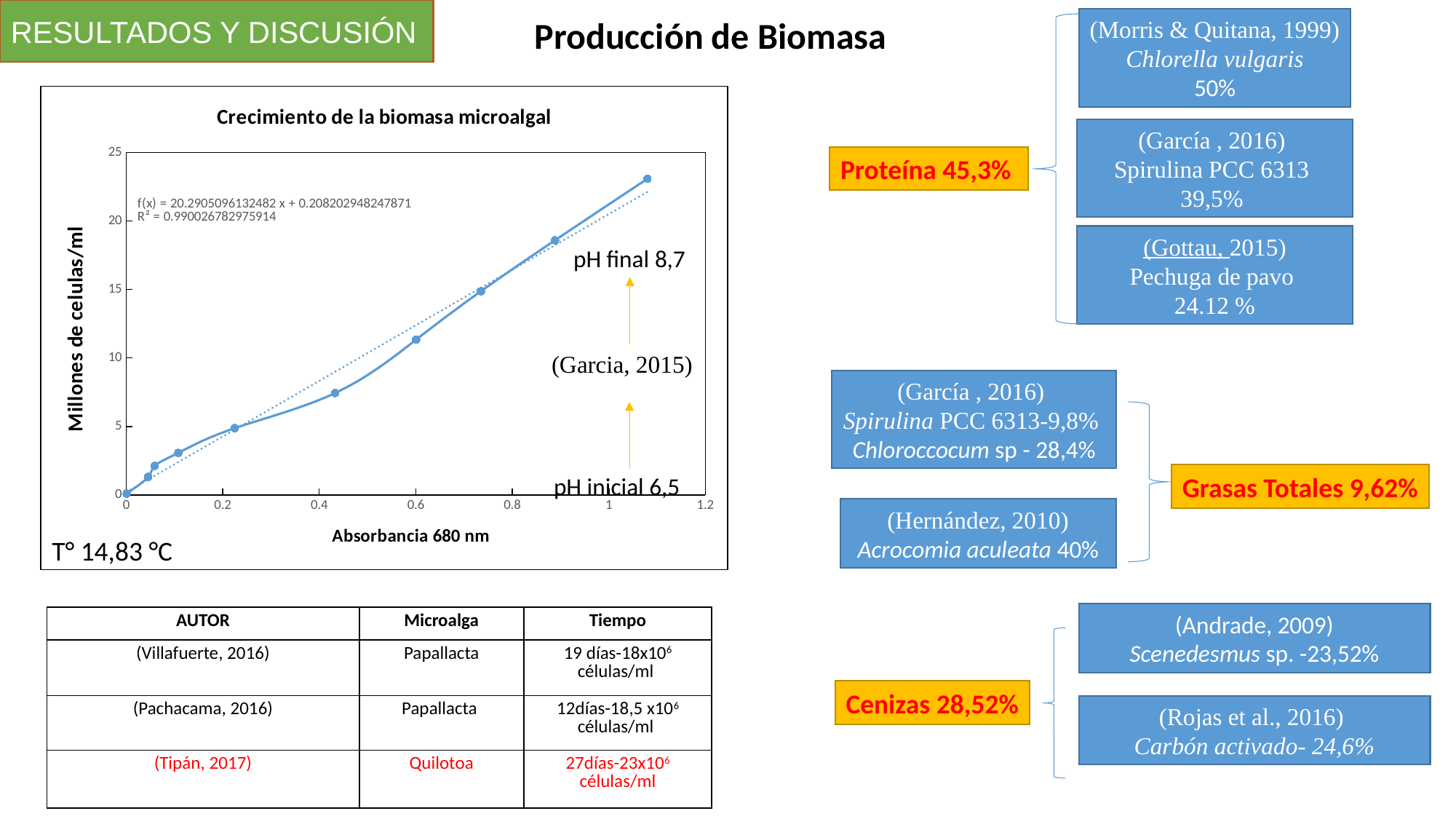
What is the label of the y axis of the chart? Millones de celulas/ml Is the value of the data point at an absorbance of about 0.9 greater or less than 20 million cells/ml? less What is the maximum value shown on the x axis of the chart? 1.2 What is the slope of the trendline equation f(x) shown in the chart? 20.2905096132482 Is the value of the data point at an absorbance of about 0.4 greater or less than 10 million cells/ml? less Do the values in the chart rise or fall as absorbance increases along the x axis? rise What kind of chart is shown on the slide? line chart What is the R² value of the trendline shown in the chart? 0.990026782975914 Which of the two data points has the larger value: the one at an absorbance of about 0.6 or the one at about 0.9? the one at about 0.9 What is the title of the chart on the slide? Crecimiento de la biomasa microalgal Is the value of the data point at an absorbance of about 0.6 greater or less than 10 million cells/ml? greater